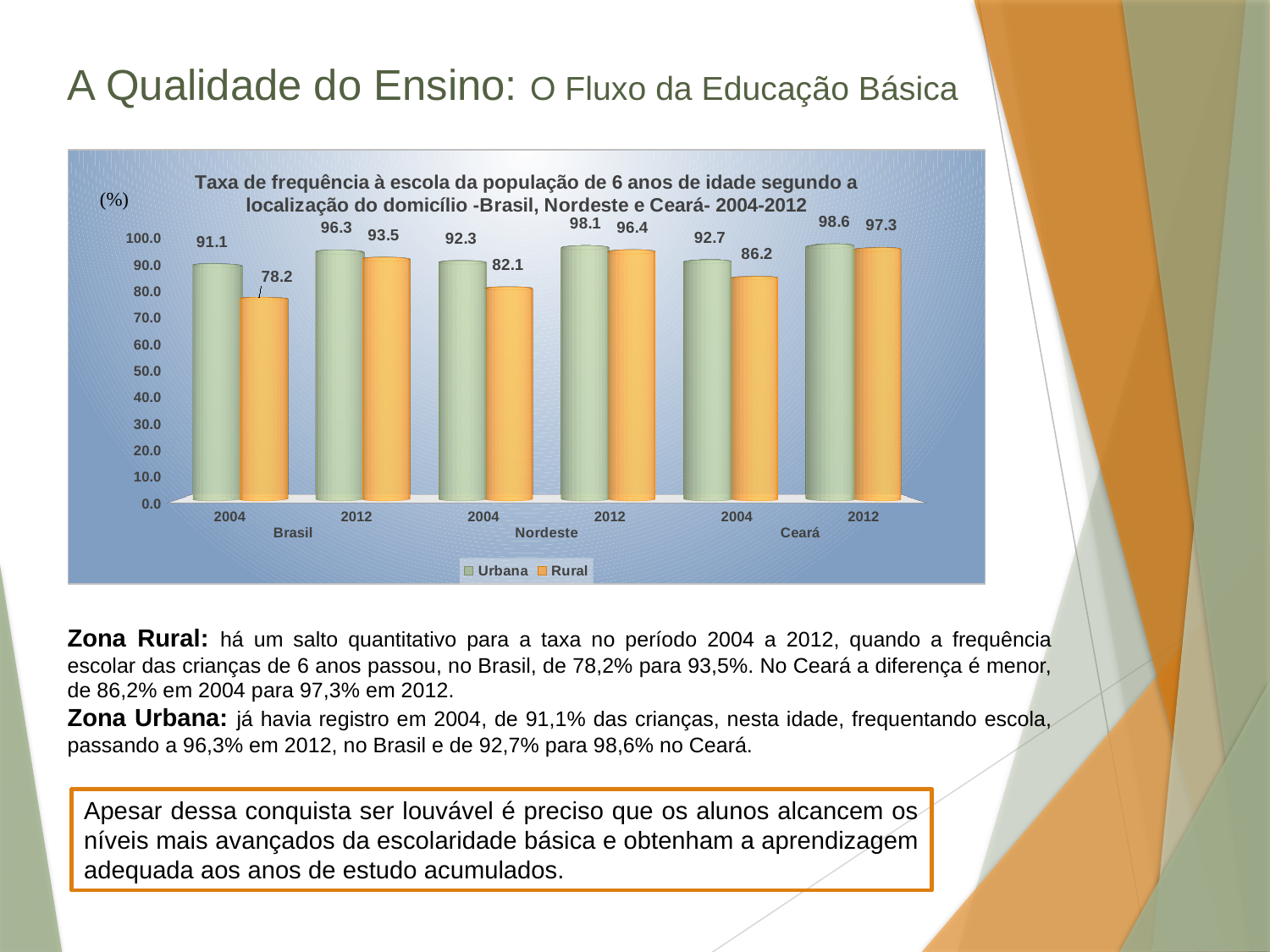
Which series is shown in orange in the legend? Rural What is the difference between the Rural values for Ceará in 2012 and 2004? 11.1 Which is larger, the Rural value for Nordeste in 2004 or the Rural value for Ceará in 2004? Ceará 2004 How many series does the legend list? 2 Which category has the lowest Rural value? Brasil 2004 How many bars are plotted in the chart? 12 What is the difference between the Urbana and Rural values for Brasil in 2004? 12.9 What kind of chart is shown on the slide? Bar chart What is the Rural value for Nordeste in 2012? 96.4 Which category has the highest Urbana value? Ceará 2012 What is the Urbana value for Brasil in 2004? 91.1 What is the Rural value for Ceará in 2004? 86.2